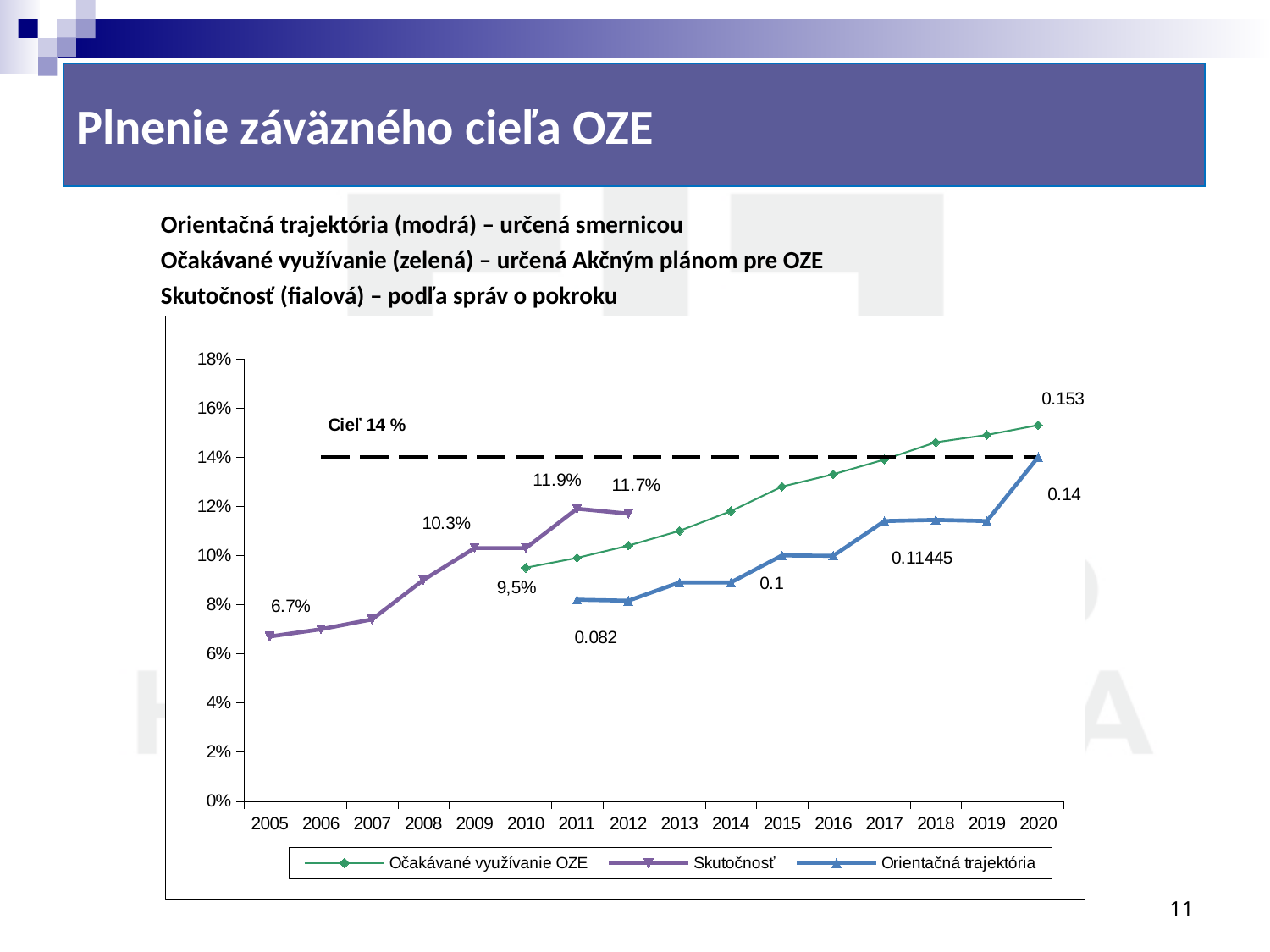
What is the value of the Skutočnosť series in 2011? 11.9% Which series has the highest value in 2020? Očakávané využívanie OZE What type of chart is shown on the slide? line chart What is the value of the Očakávané využívanie OZE series in 2020? 0.153 What target value is marked by the dashed line on the chart? 14 % What is the value of the Orientačná trajektória series in 2020? 0.14 How many years are shown on the x axis of the chart? 16 Is the value of the Očakávané využívanie OZE series in 2015 greater or less than 12%? greater What is the value of the Skutočnosť series in 2005? 6.7% What is the value of the Orientačná trajektória series in 2011? 0.082 Which is larger for the Skutočnosť series: the value in 2011 or the value in 2012? 2011 How many series does the chart legend list? 3